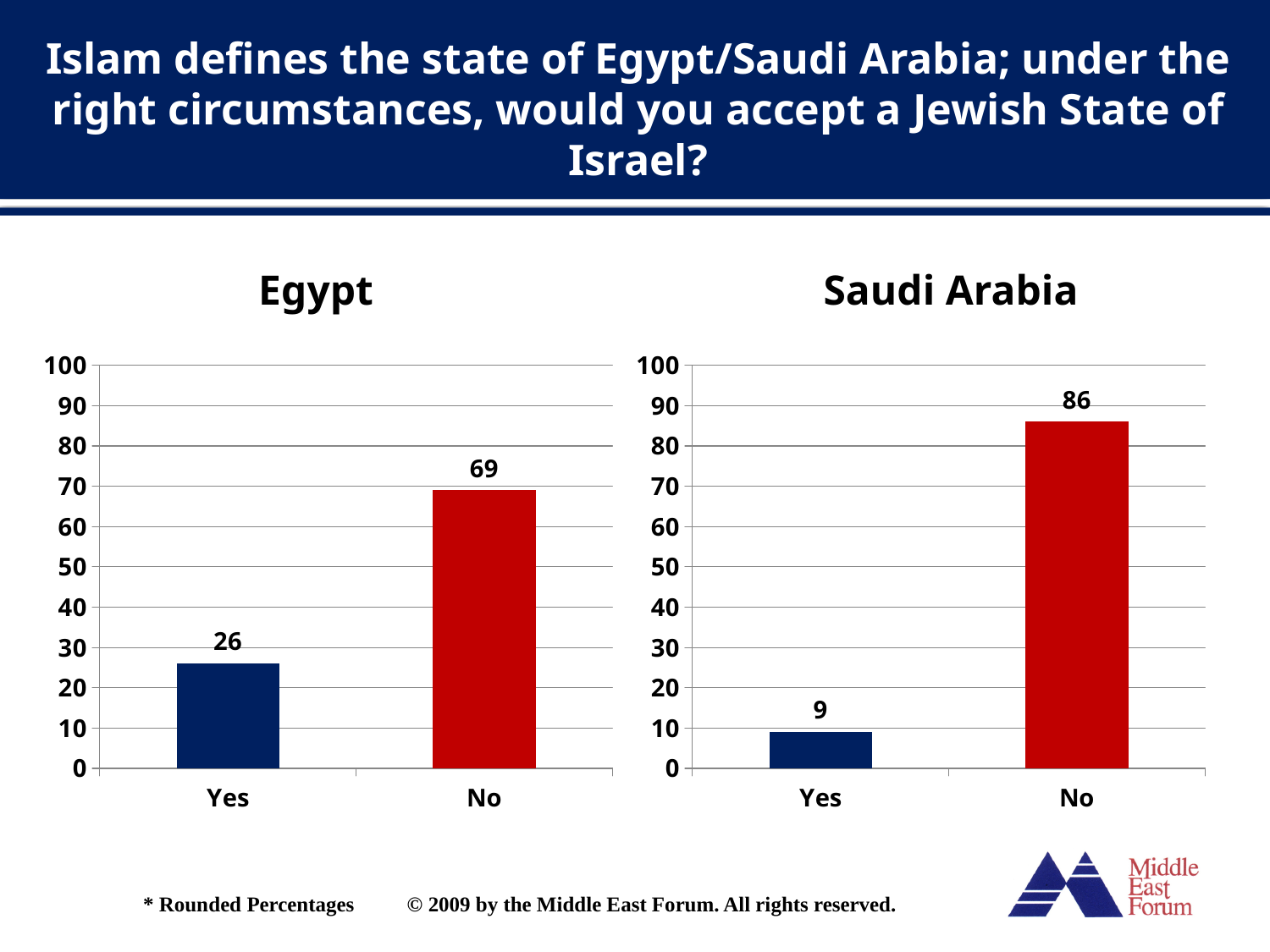
In the Saudi Arabia chart, which category has the lowest value? Yes In the Saudi Arabia chart, what is the value for No? 86 In the Egypt chart, what is the difference between the No and Yes values? 43 What kind of chart is the Egypt chart? bar chart In the Egypt chart, what is the value for No? 69 Is the Yes value in the Egypt chart larger or smaller than the Yes value in the Saudi Arabia chart? larger How many categories are shown in the Saudi Arabia chart? 2 In the Egypt chart, which category has the highest value? No In the Egypt chart, what is the value for Yes? 26 In the Saudi Arabia chart, what is the difference between the No and Yes values? 77 What colour is the No bar in the Saudi Arabia chart? red In the Saudi Arabia chart, what is the value for Yes? 9